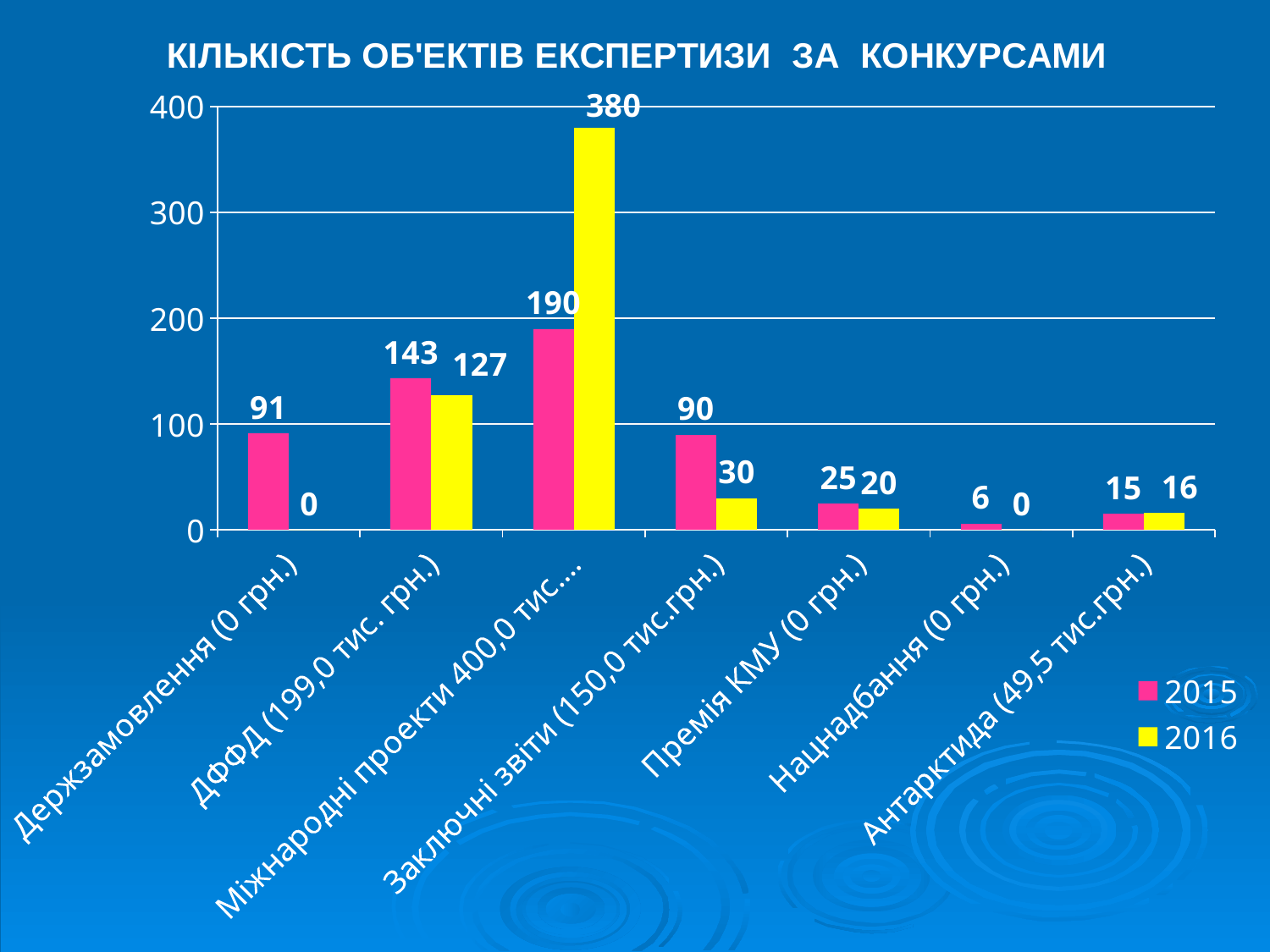
How many series does the legend list? 2 What is the 2015 value for Держзамовлення (0 грн.)? 91 What is the 2015 value for Антарктида (49,5 тис.грн.)? 15 Which category has the lowest 2015 value? Нацнадбання (0 грн.) What is the difference between the 2016 and 2015 values for Міжнародні проекти? 190 Which category has the highest 2016 value? Міжнародні проекти What kind of chart is shown on the slide? bar chart Which is larger for Премія КМУ (0 грн.): the 2015 value or the 2016 value? 2015 What is the 2016 value for Заключні звіти (150,0 тис.грн.)? 30 What is the title of the chart? КІЛЬКІСТЬ ОБ'ЕКТІВ ЕКСПЕРТИЗИ ЗА КОНКУРСАМИ What is the 2016 value for ДФФД (199,0 тис. грн.)? 127 How many categories are shown on the x axis? 7